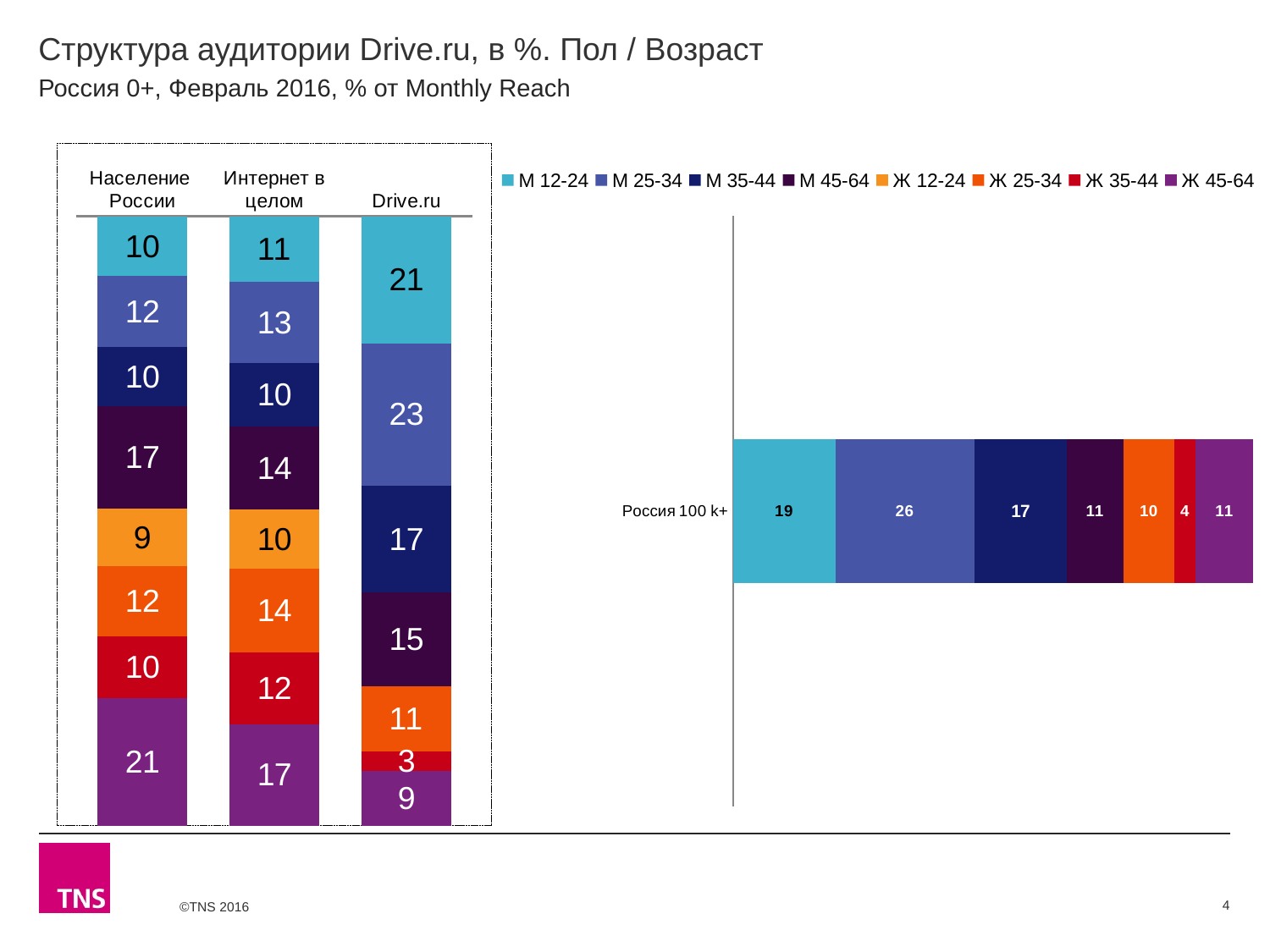
In the left chart, which is larger: Ж 45-64 for Население России or Ж 45-64 for Drive.ru? Население России In the right chart (Россия 100 k+), which segment has the largest value? М 25-34 In the left chart, what is the value for М 12-24 in the Drive.ru column? 21 How many series does the legend list? 8 In the right chart (Россия 100 k+), what is the difference between М 12-24 and Ж 35-44? 15 In the right chart (Россия 100 k+), what is the value for М 25-34? 26 How many columns (categories) are shown in the left chart? 3 In the left chart, which segment of the Drive.ru column has the smallest value? Ж 35-44 What kind of chart is the right chart (Россия 100 k+)? Stacked bar chart In the left chart, what is the value for Ж 45-64 in the Население России column? 21 In the left chart, what is the value for М 45-64 in the Интернет в целом column? 14 In the left chart, what is the difference between the М 25-34 values for Drive.ru and Население России? 11